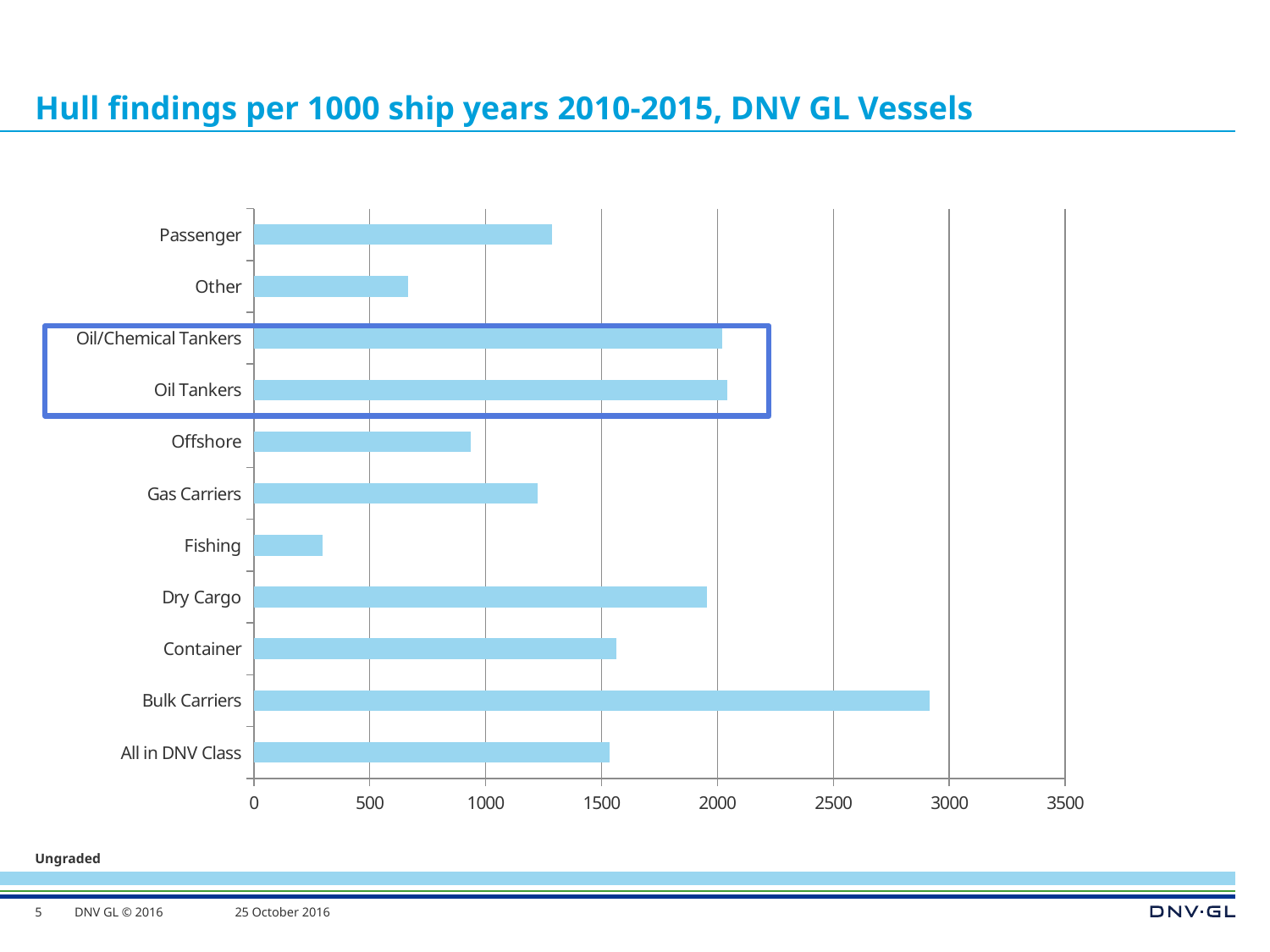
Which vessel category has the highest hull findings per 1000 ship years? Bulk Carriers How many vessel categories are plotted in the chart? 11 Which two categories are highlighted with a blue box on the chart? Oil/Chemical Tankers and Oil Tankers Is the value for Bulk Carriers greater or less than 2500? greater Which has a higher value, Bulk Carriers or Container? Bulk Carriers Is the value for Dry Cargo greater or less than 2000? less Which vessel category has the lowest hull findings per 1000 ship years? Fishing Is the value for Offshore greater or less than 1000? less What kind of chart is shown on the slide? Bar chart What is the title of the chart? Hull findings per 1000 ship years 2010-2015, DNV GL Vessels